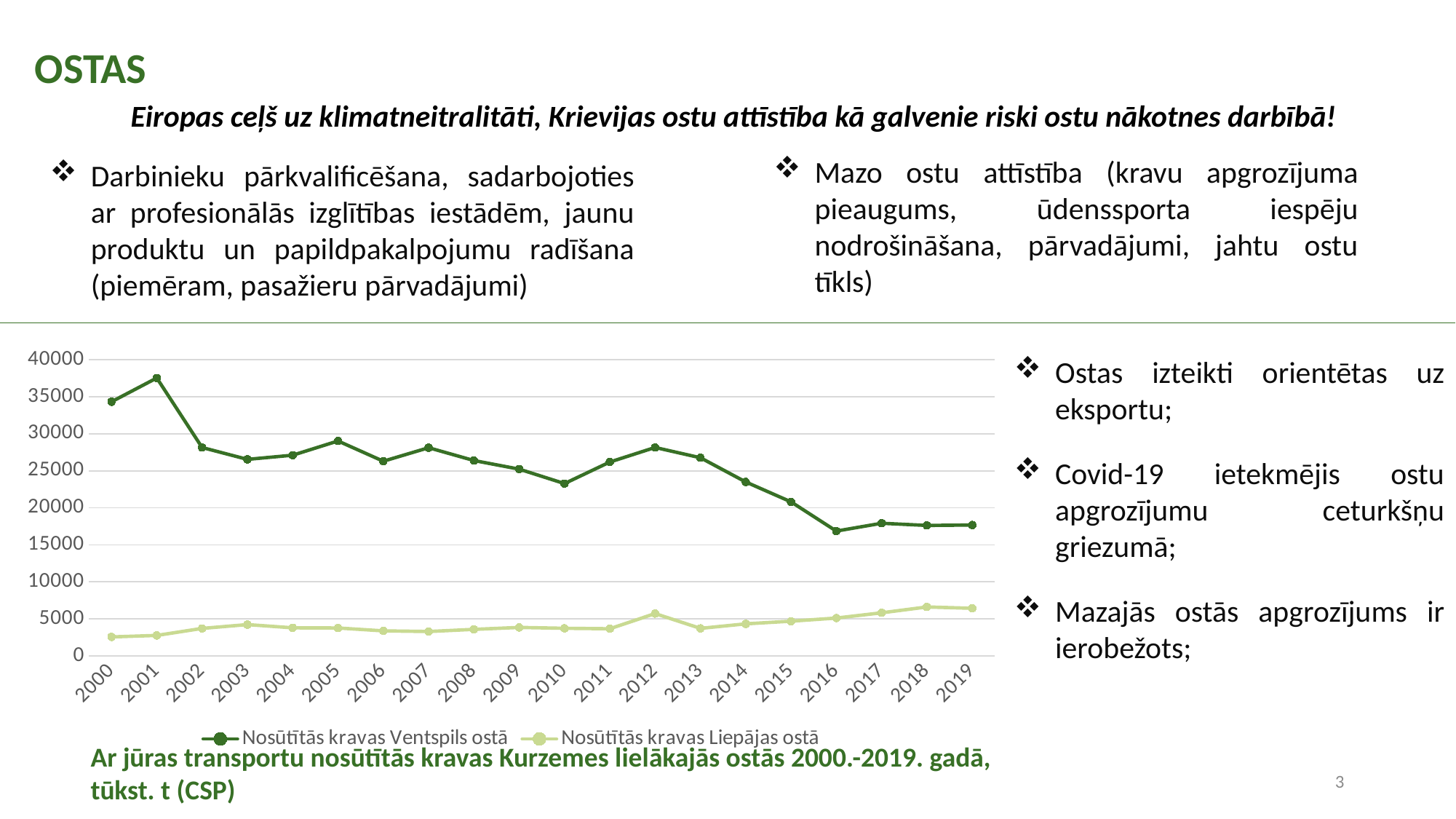
Is the value for Nosūtītās kravas Ventspils ostā in 2001 greater or less than 35000? greater Is the value for Nosūtītās kravas Liepājas ostā in 2000 greater or less than 5000? less What kind of chart is shown on the slide? line chart Is the value for Nosūtītās kravas Ventspils ostā in 2016 greater or less than 20000? less How many years are plotted along the x axis? 20 In which year is the value for Nosūtītās kravas Ventspils ostā lowest? 2016 In which year is the value for Nosūtītās kravas Ventspils ostā highest? 2001 Which is larger for Nosūtītās kravas Ventspils ostā: the value in 2001 or the value in 2002? 2001 Which series is drawn in the darker green line? Nosūtītās kravas Ventspils ostā Overall, does the Nosūtītās kravas Ventspils ostā line rise or fall from 2000 to 2019? fall How many series does the legend list? 2